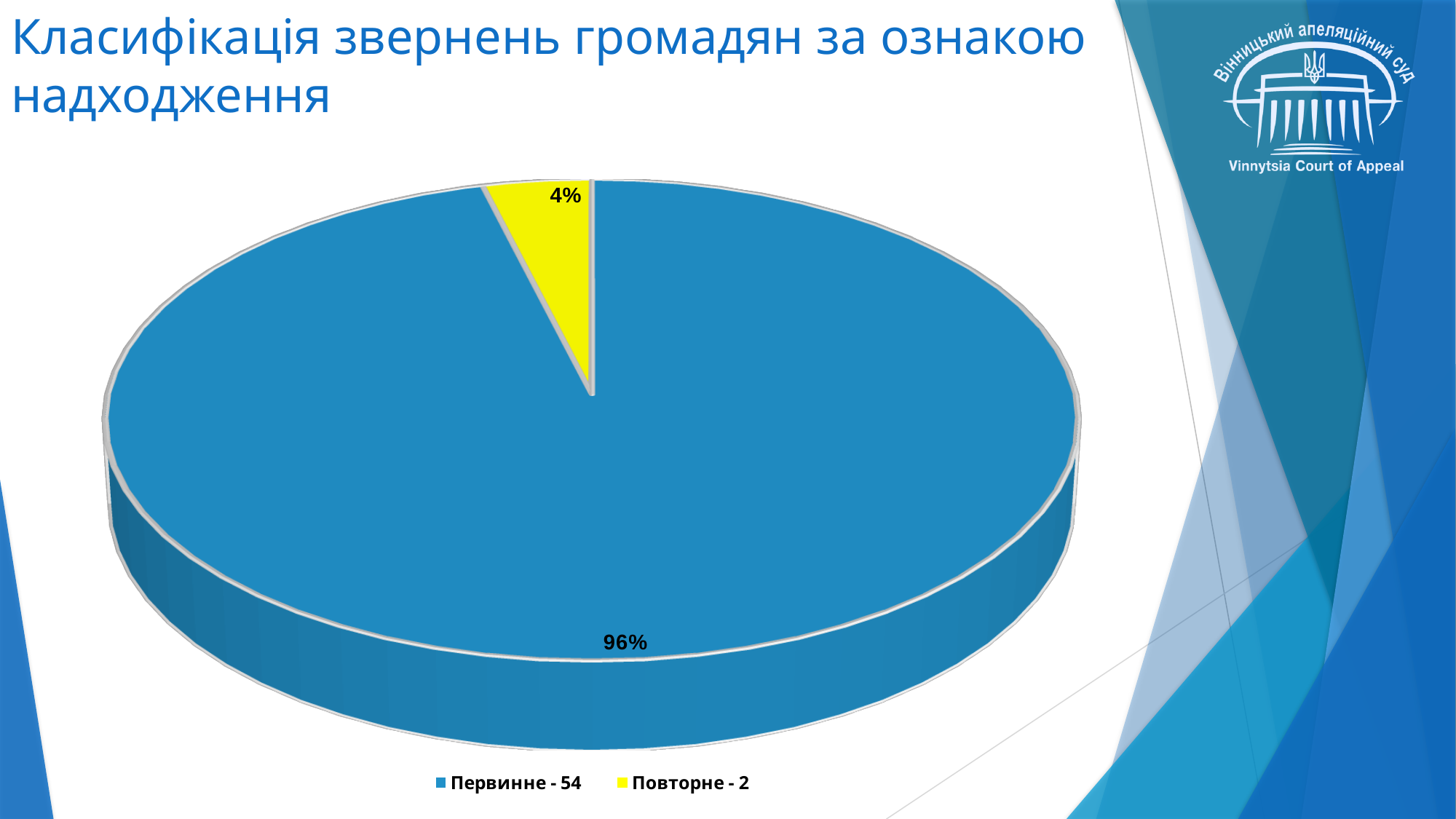
What percentage share does the "Первинне - 54" slice have? 96% What is the difference in percentage points between the "Первинне - 54" and "Повторне - 2" slices? 92 What percentage share does the "Повторне - 2" slice have? 4% Which slice is the largest in the pie chart? Первинне - 54 How many entries does the legend list? 2 Which is larger: the "Первинне - 54" slice or the "Повторне - 2" slice? Первинне - 54 What is the title of the slide containing the chart? Класифікація звернень громадян за ознакою надходження Which slice is the smallest in the pie chart? Повторне - 2 What colour is the "Повторне - 2" slice? yellow How many slices does the pie chart have? 2 What kind of chart is shown on the slide? pie chart